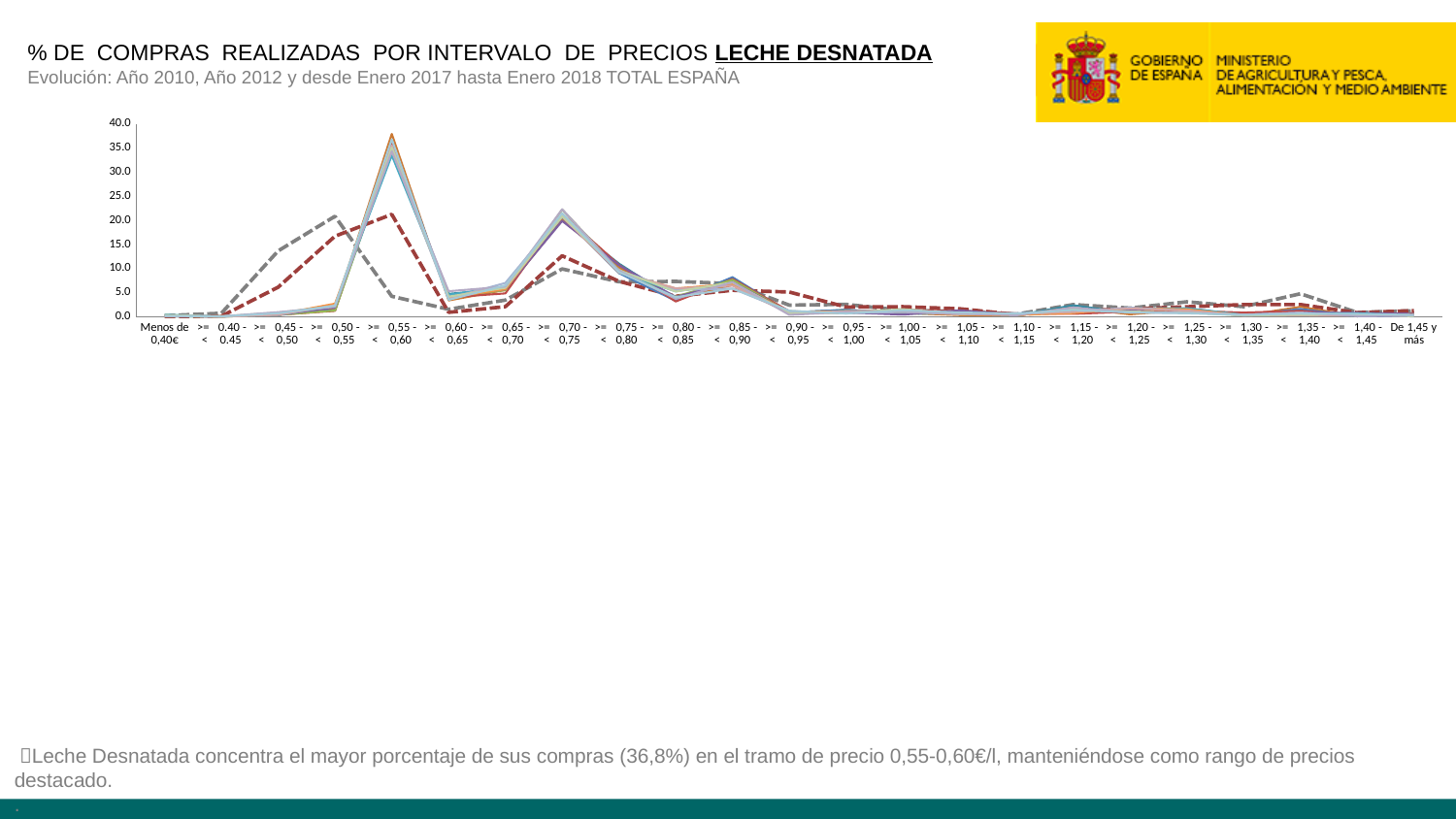
Is the highest value plotted at the >= 0,70 - < 0,75 interval greater or less than 15? greater Do the solid lines rise or fall from the >= 0,55 - < 0,60 interval to the >= 0,60 - < 0,65 interval? fall What kind of chart is shown on the slide? line chart In which price interval do the solid lines reach their highest value? >= 0,55 - < 0,60 Which interval has the larger values for the solid lines: >= 0,55 - < 0,60 or >= 0,70 - < 0,75? >= 0,55 - < 0,60 According to the slide text, what percentage of Leche Desnatada purchases falls in the 0,55-0,60€/l price range? 36,8% What is the title of the chart on the slide? % DE COMPRAS REALIZADAS POR INTERVALO DE PRECIOS LECHE DESNATADA Is the highest value plotted at the >= 0,70 - < 0,75 interval greater or less than 25? less What is the highest tick value shown on the y axis of the chart? 40.0 How many price-interval categories are shown on the x axis of the chart? 23 Are the values at the >= 1,00 - < 1,05 interval greater or less than 5? less